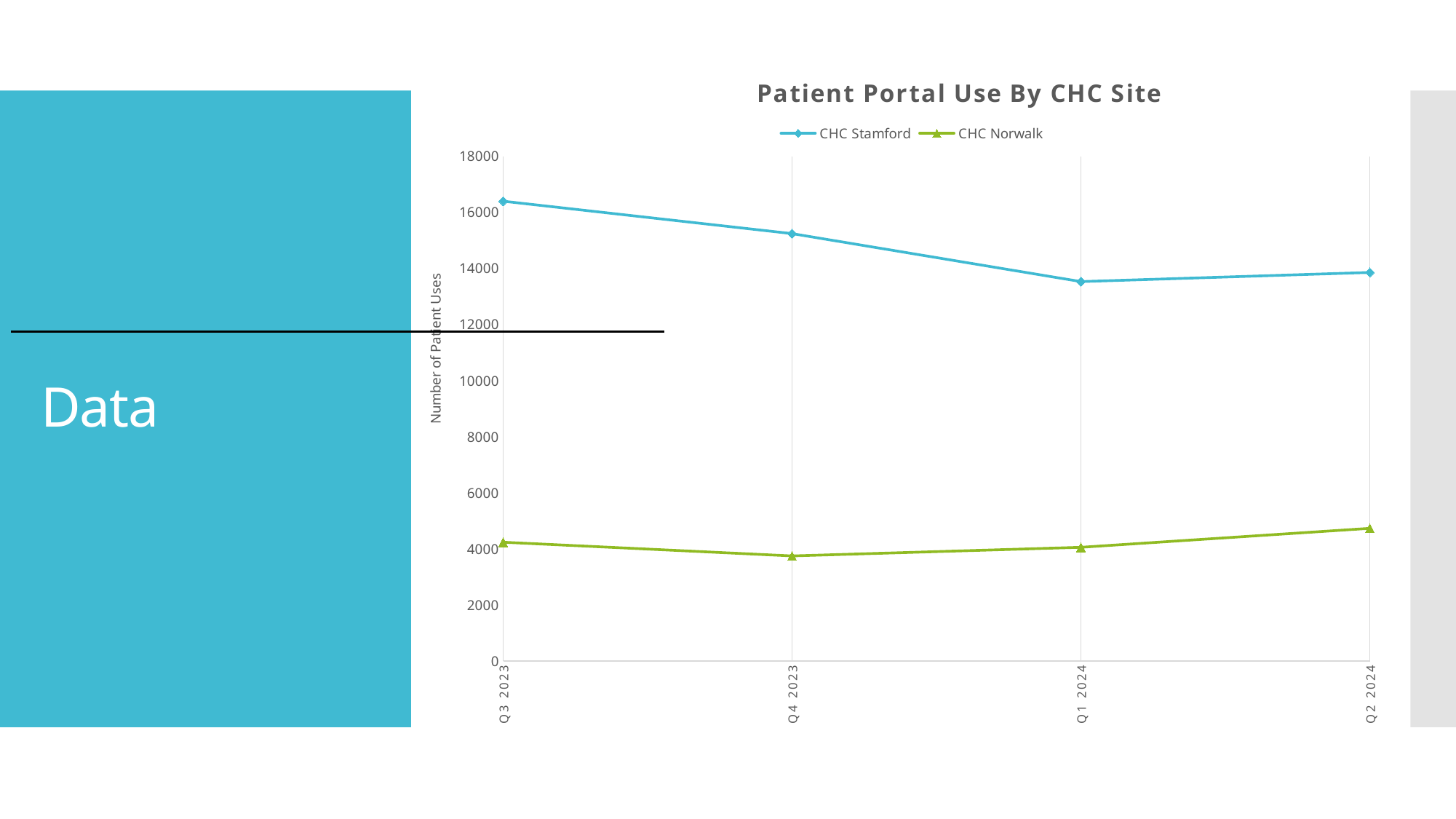
What kind of chart is shown on the slide? Line chart What is the title of the chart? Patient Portal Use By CHC Site Which site has the higher number of patient uses in Q2 2024, CHC Stamford or CHC Norwalk? CHC Stamford Is the value for CHC Stamford in Q1 2024 greater or less than 14000? less How many series does the legend list? 2 Is the value for CHC Norwalk in Q2 2024 greater or less than 4000? greater What is the label on the vertical axis? Number of Patient Uses In which quarter is CHC Norwalk's patient portal use lowest? Q4 2023 Is the value for CHC Stamford in Q3 2023 greater or less than 16000? greater In which quarter is CHC Stamford's patient portal use highest? Q3 2023 How many quarters are plotted along the x axis? 4